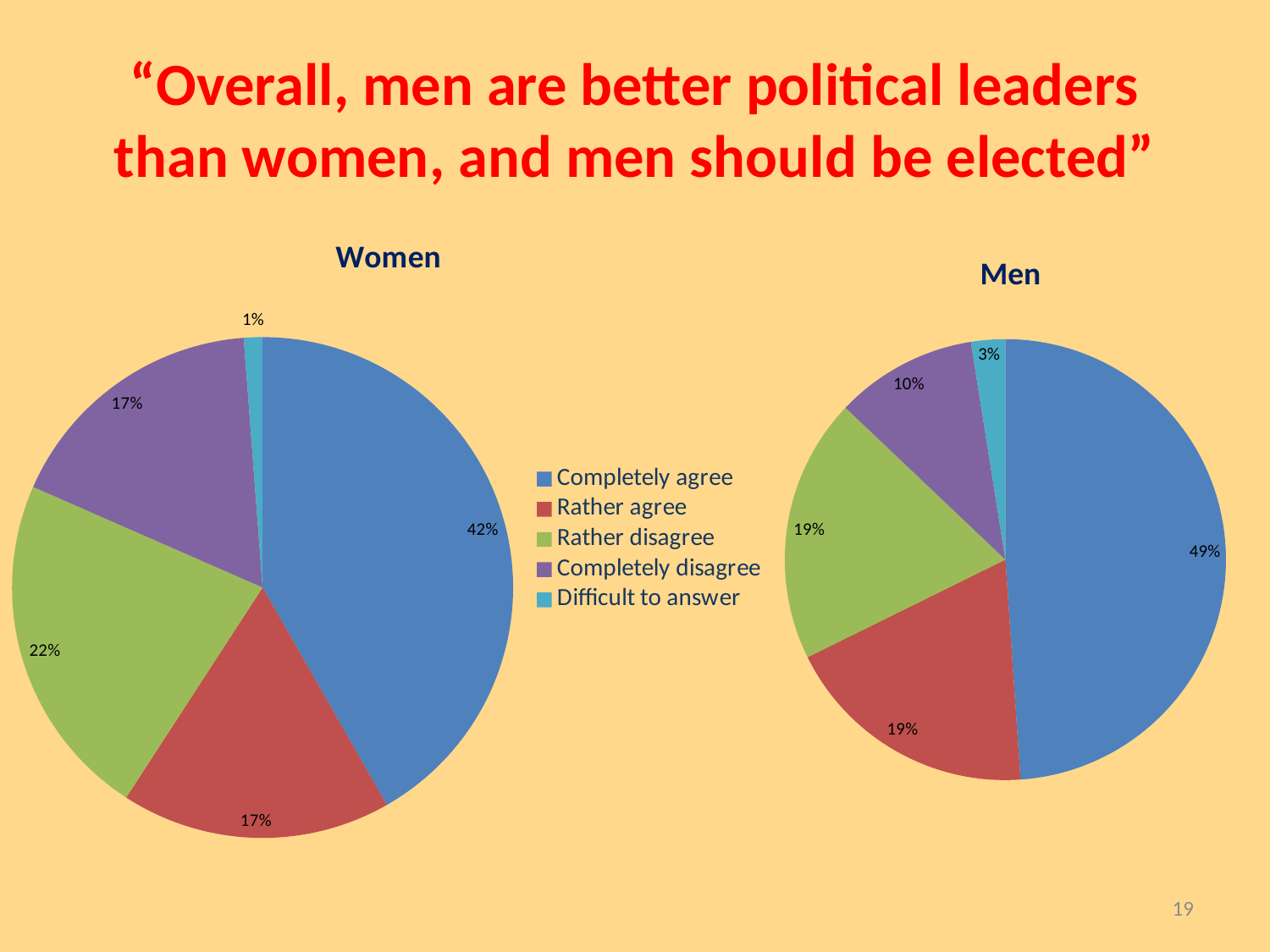
In the Women chart, what percentage of respondents chose "Completely agree"? 42% In the Men chart, what is the share for "Completely disagree"? 10% What is the difference between the "Completely agree" share in the Men chart and in the Women chart? 7% In the Women chart, what is the share for "Rather disagree"? 22% In the Women chart, which response has the smallest slice? Difficult to answer How many response categories does the legend list? 5 What type of chart is used for the Women and Men data? Pie chart In the Men chart, what percentage of respondents chose "Completely agree"? 49% In the Men chart, what is the share for "Difficult to answer"? 3% In the Men chart, which response has the largest slice? Completely agree In the Women chart, which is larger: "Rather disagree" or "Rather agree"? Rather disagree Which colour represents "Completely disagree" in the legend? Purple